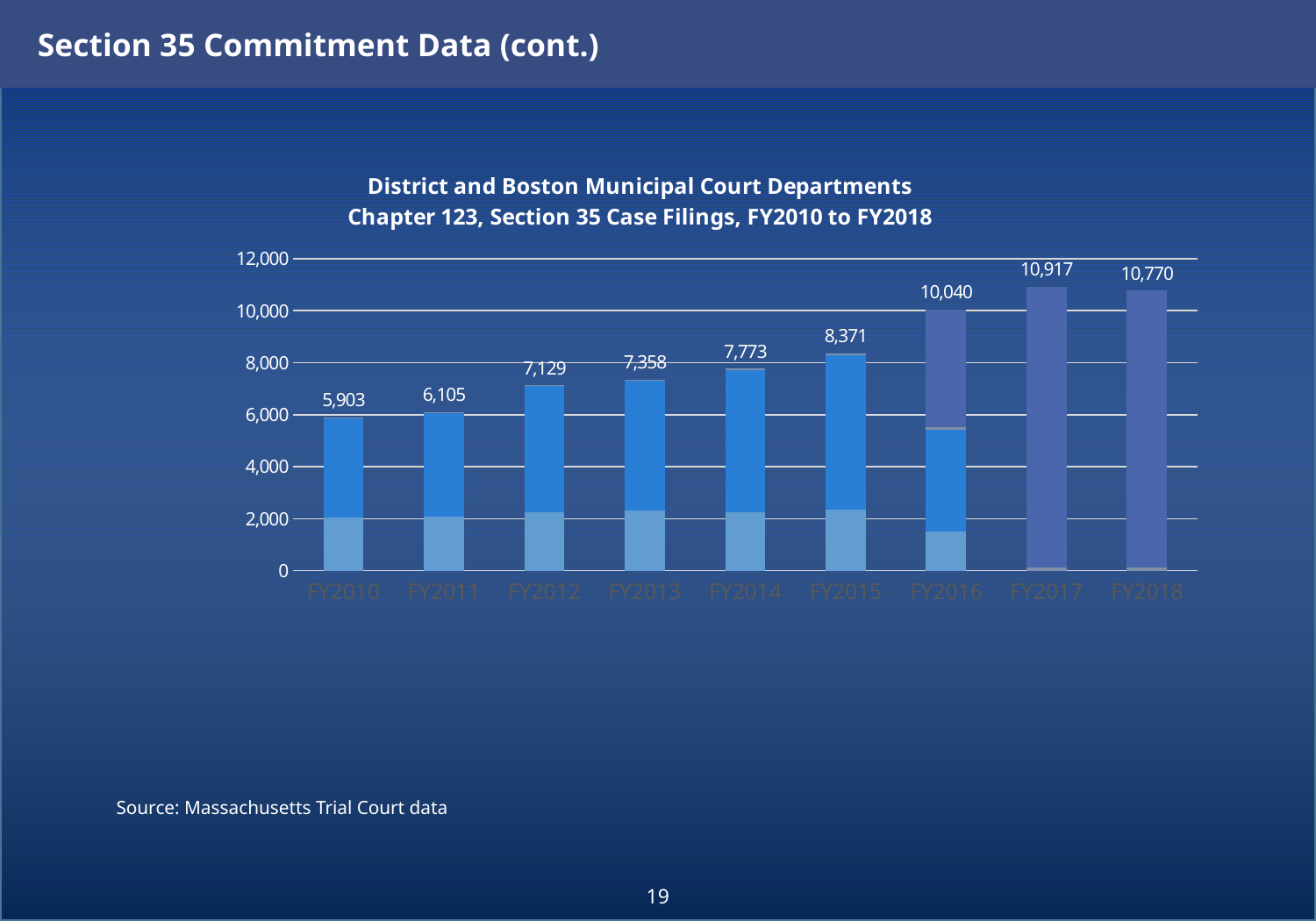
Do the total case filings generally rise or fall from FY2010 to FY2017? Rise What is the difference between the totals for FY2017 and FY2016? 877 What is the difference between the totals for FY2018 and FY2010? 4,867 Is the total for FY2016 greater or less than 10,000? greater What is the total value shown for FY2015? 8,371 Which fiscal year has the lowest total case filings? FY2010 Which fiscal year has the highest total case filings? FY2017 What is the total value shown for FY2010? 5,903 What is the total value shown for FY2018? 10,770 What kind of chart is shown on the slide? Stacked bar chart Which is larger, the total for FY2013 or the total for FY2014? FY2014 How many fiscal years are shown on the x axis? 9